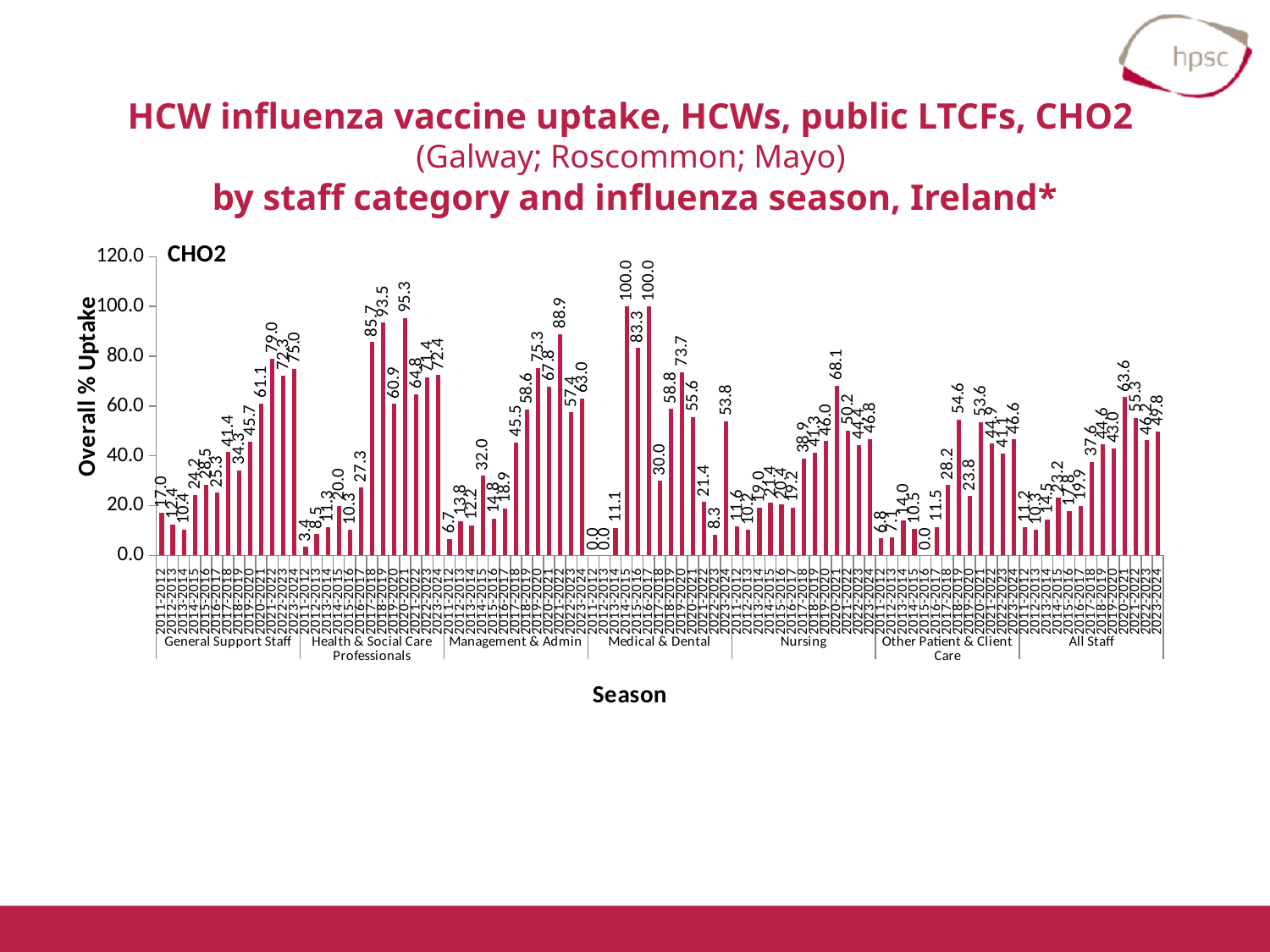
What is the difference in overall % uptake for General Support Staff between 2021-2022 and 2020-2021? 17.9 What is the overall % uptake for Nursing in the 2020-2021 season? 68.1 What is the highest value reached by any bar in the Medical & Dental group? 100.0 Is the overall % uptake for Other Patient & Client Care in 2018-2019 greater or less than 40.0? greater What is the overall % uptake for All Staff in the 2020-2021 season? 63.6 Which is larger: the overall % uptake for Medical & Dental in 2019-2020 or for Nursing in 2019-2020? Medical & Dental in 2019-2020 What is the overall % uptake for Health & Social Care Professionals in the 2020-2021 season? 95.3 What kind of chart is shown on the slide? Bar chart Which season has the lowest overall % uptake for Health & Social Care Professionals? 2011-2012 What is the label on the y axis of the chart? Overall % Uptake Which season has the highest overall % uptake for Management & Admin? 2021-2022 How many staff categories are shown on the x axis? 7